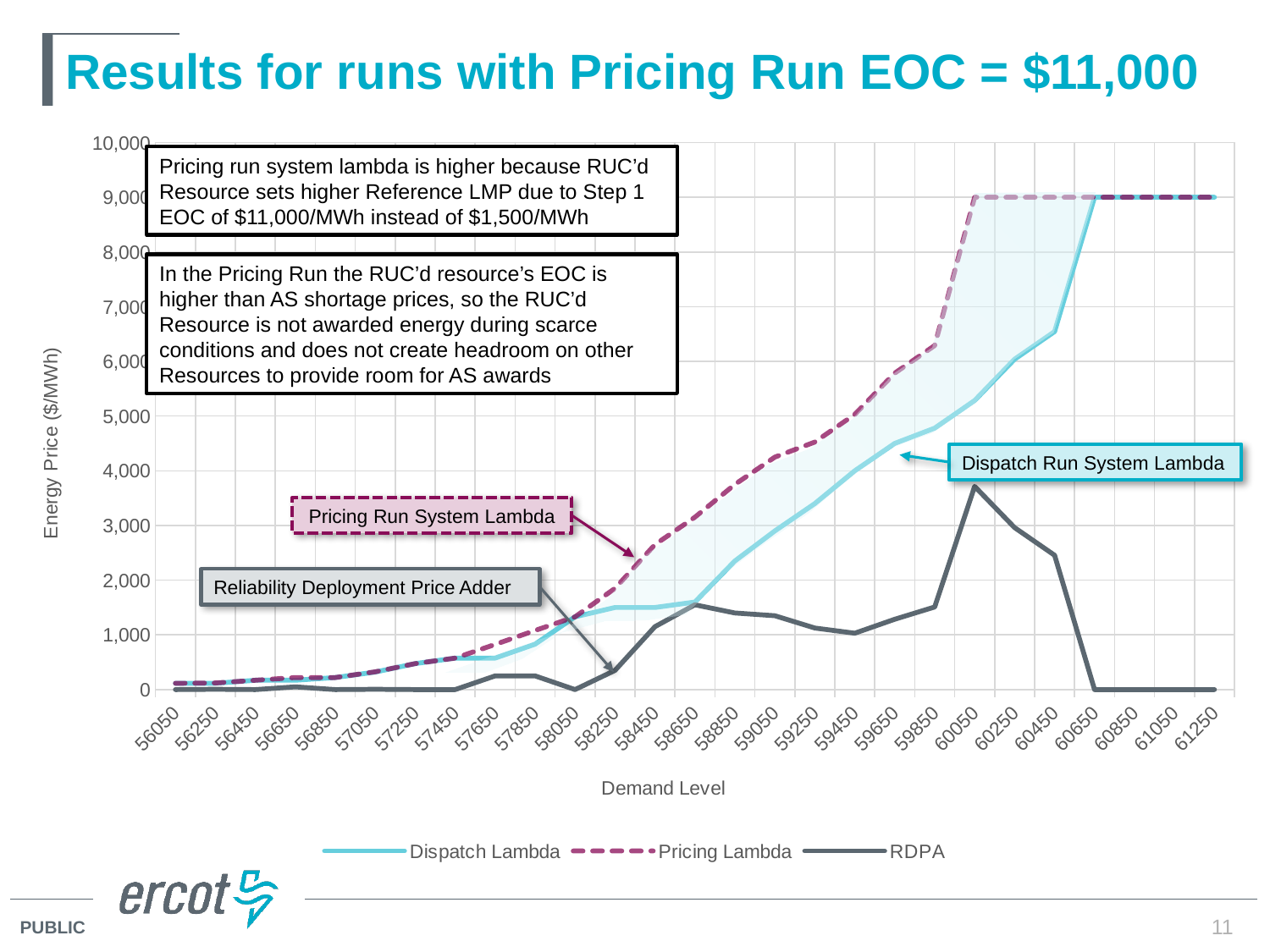
How many series does the legend list? 3 What is the label of the y axis? Energy Price ($/MWh) Does the Pricing Lambda series generally rise or fall as demand level increases from 56050 to 60050? rise Is the Pricing Lambda value at demand level 59850 greater or less than 5,000? greater At demand level 59450, which is larger, Pricing Lambda or Dispatch Lambda? Pricing Lambda What is the RDPA value at demand level 61250? 0 What are the three series named in the legend? Dispatch Lambda, Pricing Lambda, RDPA Is the Dispatch Lambda value at demand level 59850 greater or less than 5,000? less How many demand level categories are labelled on the x axis? 27 What kind of chart is shown on the slide? line chart Is the RDPA value at demand level 60050 greater or less than 3,000? greater What value does the Pricing Lambda series plateau at from demand level 60050 onward? 9,000